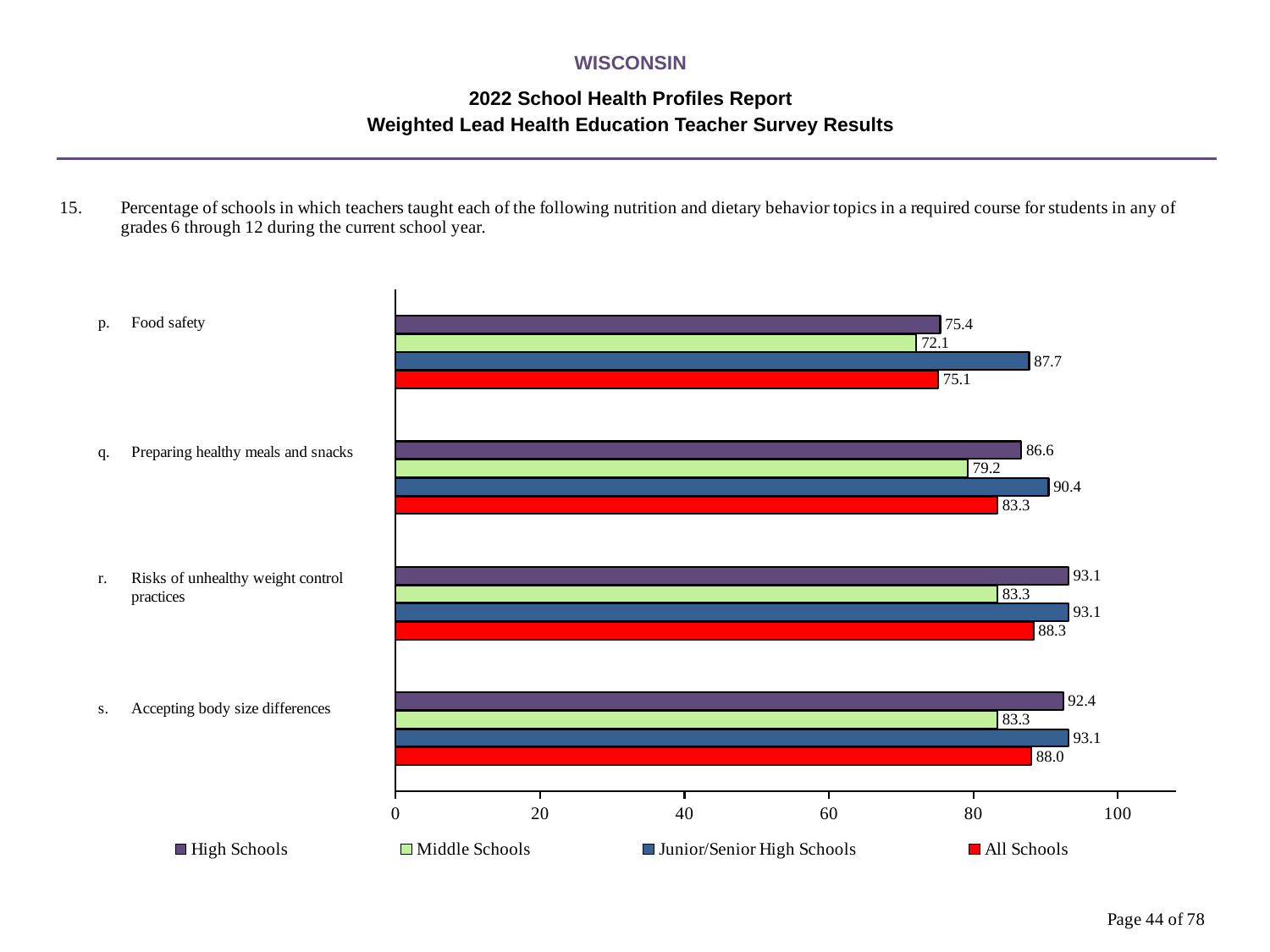
Which topic has the lowest value for All Schools? Food safety How many series does the legend list? 4 What is the value for Middle Schools for Food safety? 72.1 What kind of chart is shown on the slide? Bar chart What is the value for All Schools for Accepting body size differences? 88.0 Which topic has the highest value for High Schools? Risks of unhealthy weight control practices Is the value for Middle Schools for Risks of unhealthy weight control practices greater or less than 80? greater How many topics (categories) are shown on the chart? 4 Which series is shown in red in the legend? All Schools What is the difference between the Junior/Senior High Schools and Middle Schools values for Food safety? 15.6 Which is larger for Preparing healthy meals and snacks: High Schools or Middle Schools? High Schools What is the value for Junior/Senior High Schools for Preparing healthy meals and snacks? 90.4